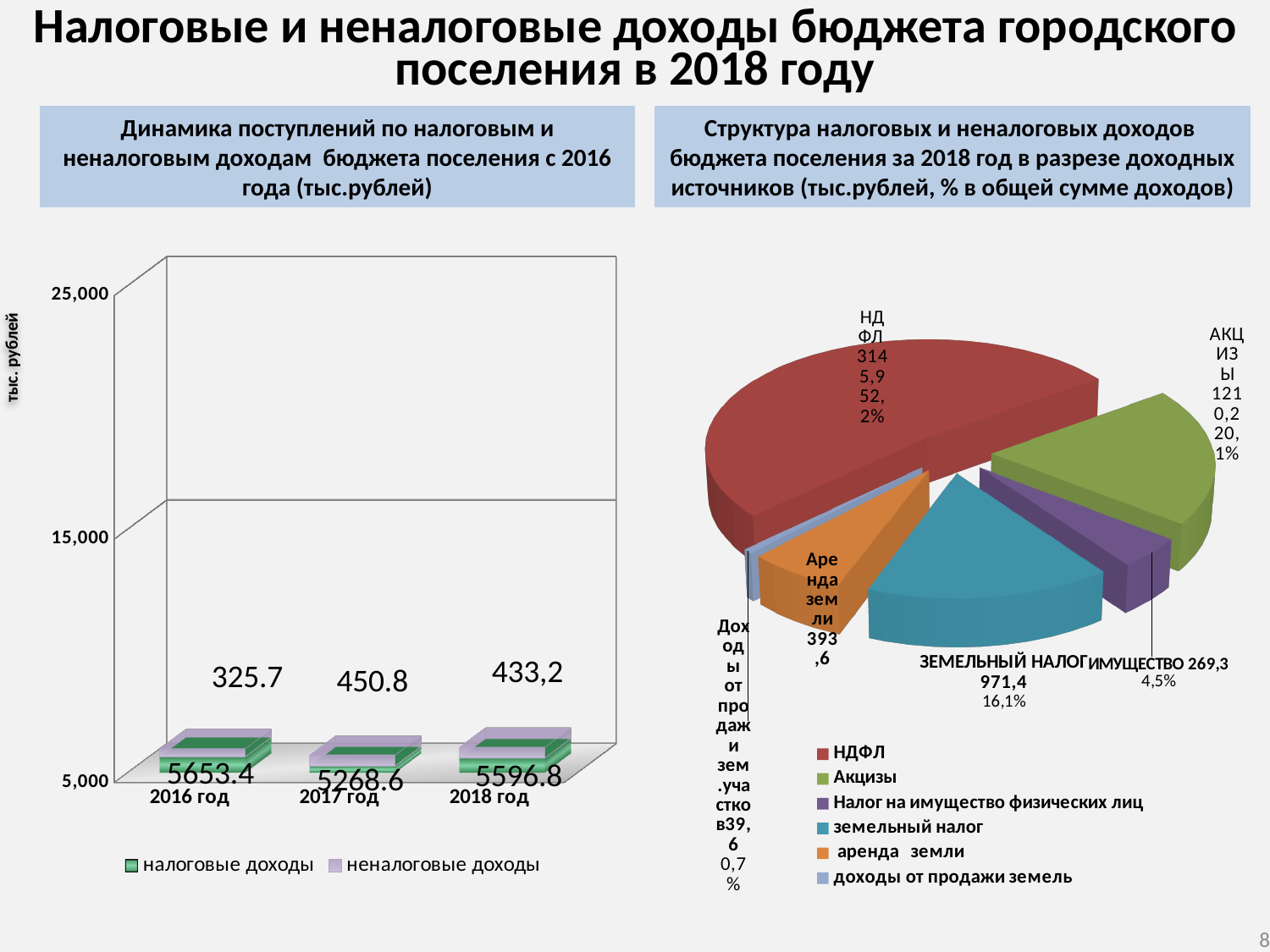
On the left bar chart, what is the value of налоговые доходы for 2017 год? 5268.6 On the right pie chart, which category has the largest slice? НДФЛ On the right pie chart, how many categories does the legend list? 6 What kind of chart is shown on the left side of the slide? Bar chart On the right pie chart, what is the value shown for ЗЕМЕЛЬНЫЙ НАЛОГ? 971,4 On the left bar chart, what is the difference between налоговые доходы in 2016 год and 2017 год? 384.8 On the left bar chart, in which year are налоговые доходы highest? 2016 год On the left bar chart, what is the value of неналоговые доходы for 2018 год? 433,2 On the right pie chart, what share of total revenue does НДФЛ represent? 52,2% On the left bar chart, in which year are неналоговые доходы lowest? 2016 год On the right pie chart, which is larger: Акцизы or ЗЕМЕЛЬНЫЙ НАЛОГ? Акцизы On the left bar chart, how many series does the legend list? 2